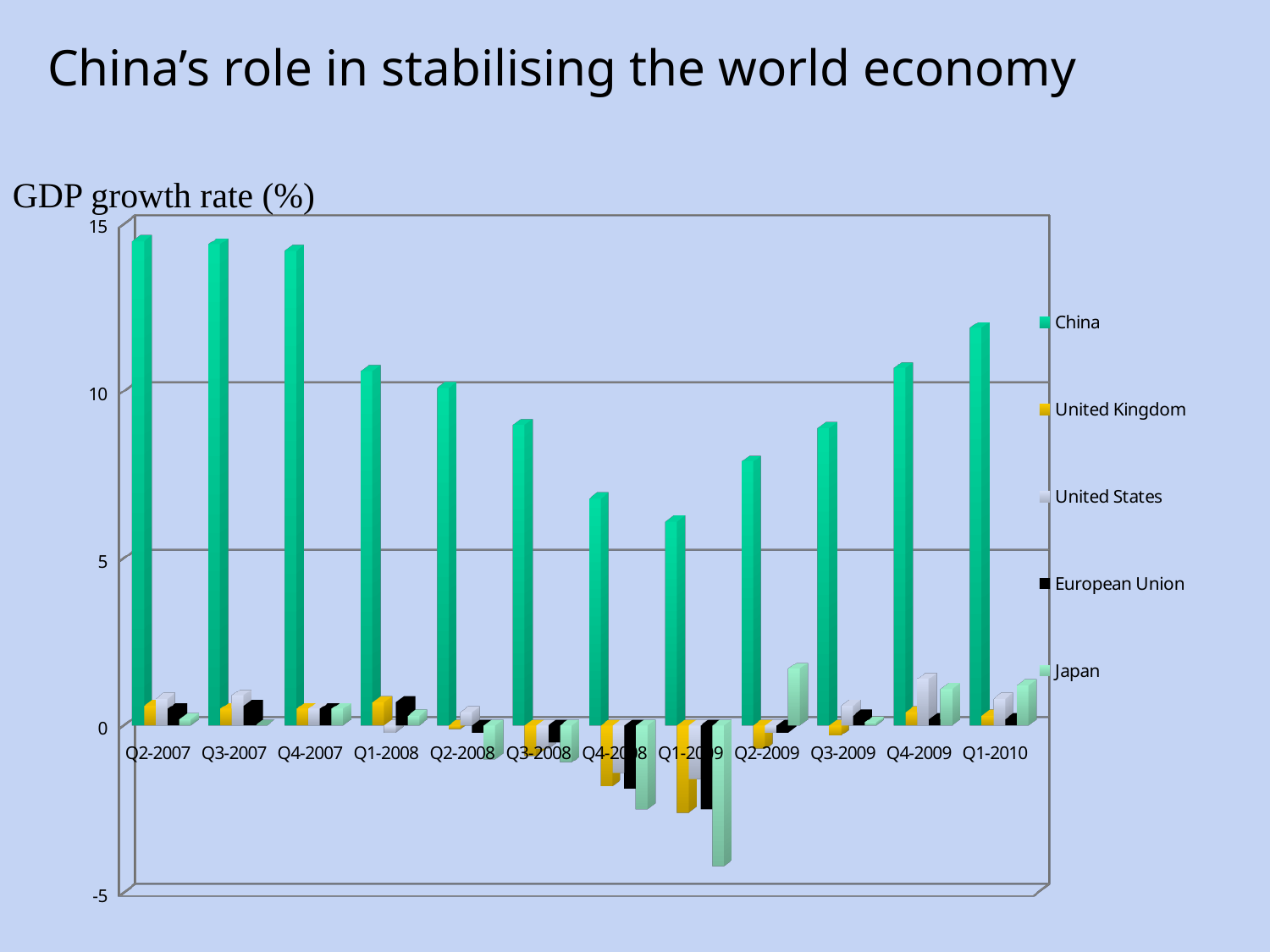
Is the value for China in Q1-2010 greater or less than 10? greater What kind of chart is shown on the slide? bar chart How many quarters are shown along the x axis? 12 Is the value for Japan in Q1-2009 greater or less than 0? less Which is larger, China's value in Q2-2009 or in Q3-2009? Q3-2009 What is the label shown above the chart's vertical axis? GDP growth rate (%) Which series has the highest value in every quarter shown? China Is the value for China in Q1-2009 greater or less than 5? greater Do China's values rise or fall from Q2-2007 to Q1-2009? fall In which quarter is China's GDP growth rate lowest? Q1-2009 How many series does the legend list? 5